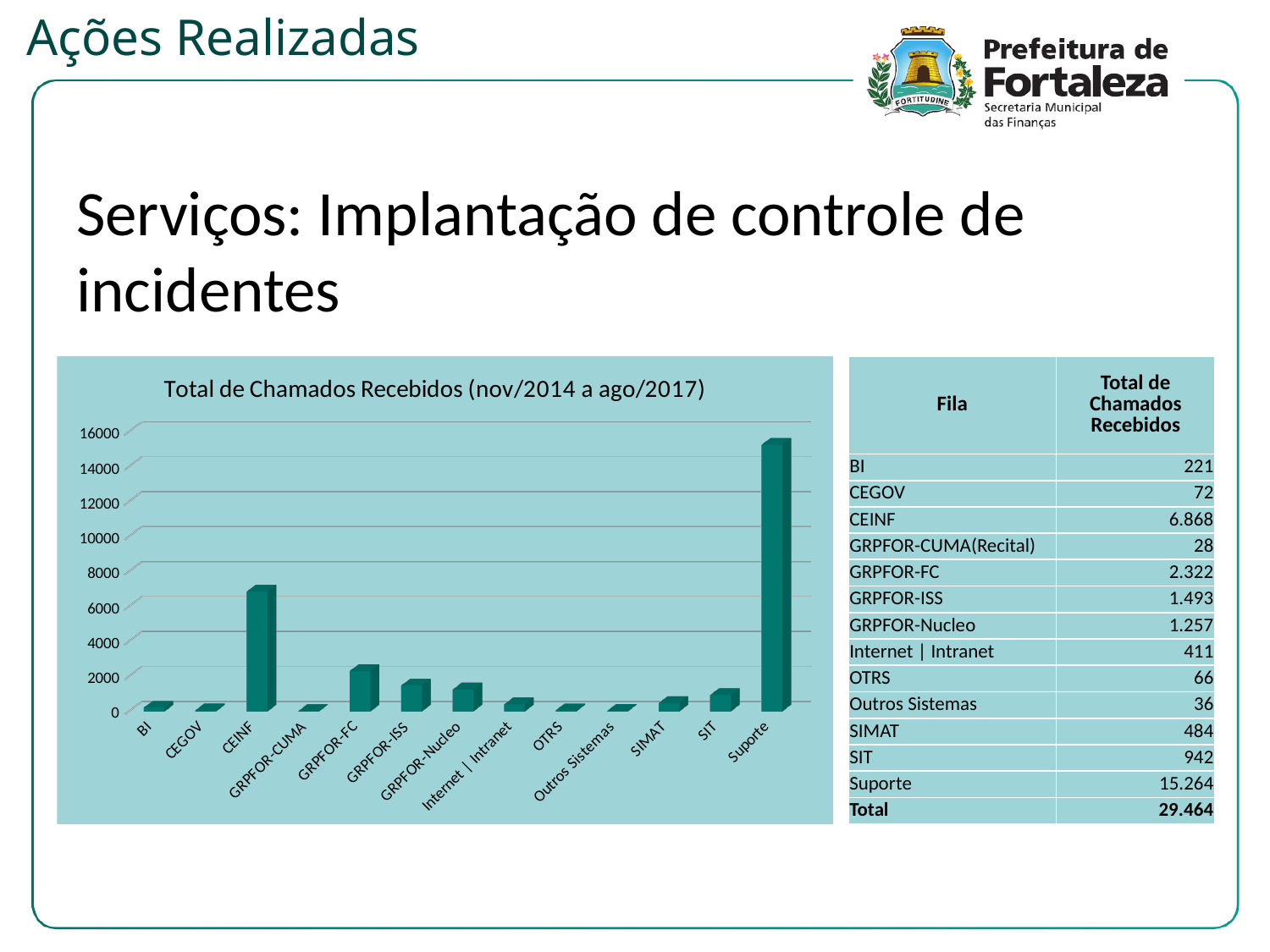
Is the value for Suporte greater or less than 14000? greater Which is larger, the value for GRPFOR-ISS or the value for SIT? GRPFOR-ISS What is the total de chamados recebidos for CEINF? 6.868 Is the value for CEINF greater or less than 8000? less What is the title of the chart? Total de Chamados Recebidos (nov/2014 a ago/2017) What is the difference between the values for Suporte and CEINF? 8.396 What is the total de chamados recebidos for Suporte? 15.264 Which category has the highest total of chamados recebidos? Suporte How many categories (filas) are plotted on the x axis of the chart? 13 Which category has the lowest total of chamados recebidos? GRPFOR-CUMA(Recital) What kind of chart is shown on the slide? Bar chart What is the total de chamados recebidos for GRPFOR-FC? 2.322